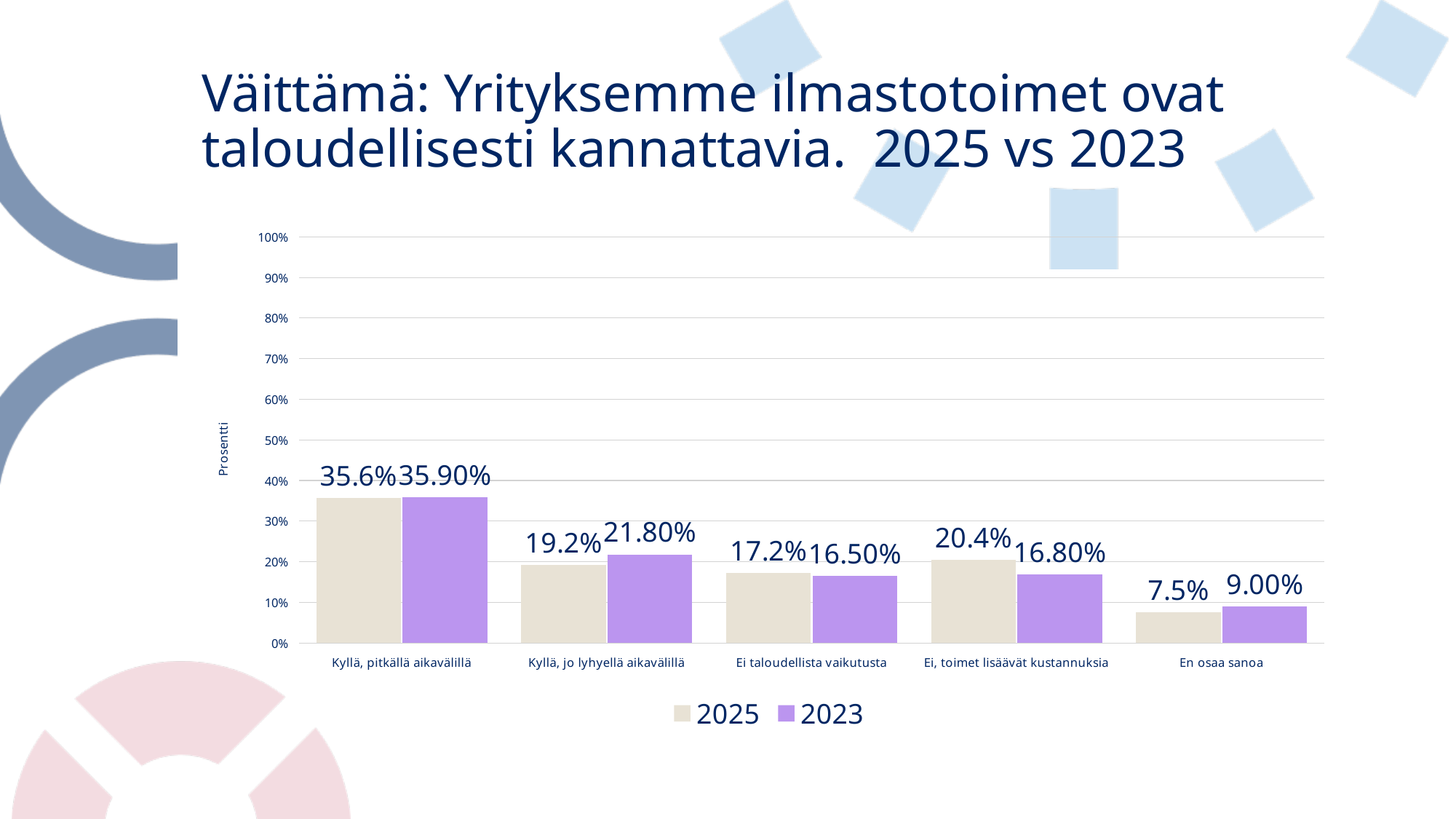
How many series does the legend list? 2 Which category has the lowest 2023 value? En osaa sanoa What is the 2025 value for "Kyllä, pitkällä aikavälillä"? 35.6% How many categories are shown on the x axis? 5 Which category has the highest 2025 value? Kyllä, pitkällä aikavälillä What is the 2023 value for "Kyllä, jo lyhyellä aikavälillä"? 21.80% What is the 2023 value for "Ei, toimet lisäävät kustannuksia"? 16.80% What is the difference between the 2025 and 2023 values for "Ei, toimet lisäävät kustannuksia"? 3.6 percentage points For "Kyllä, jo lyhyellä aikavälillä", which is larger: the 2025 value or the 2023 value? 2023 Is the 2025 value for "Ei taloudellista vaikutusta" greater or less than 20%? less What is the 2025 value for "En osaa sanoa"? 7.5% What kind of chart is shown on the slide? Bar chart